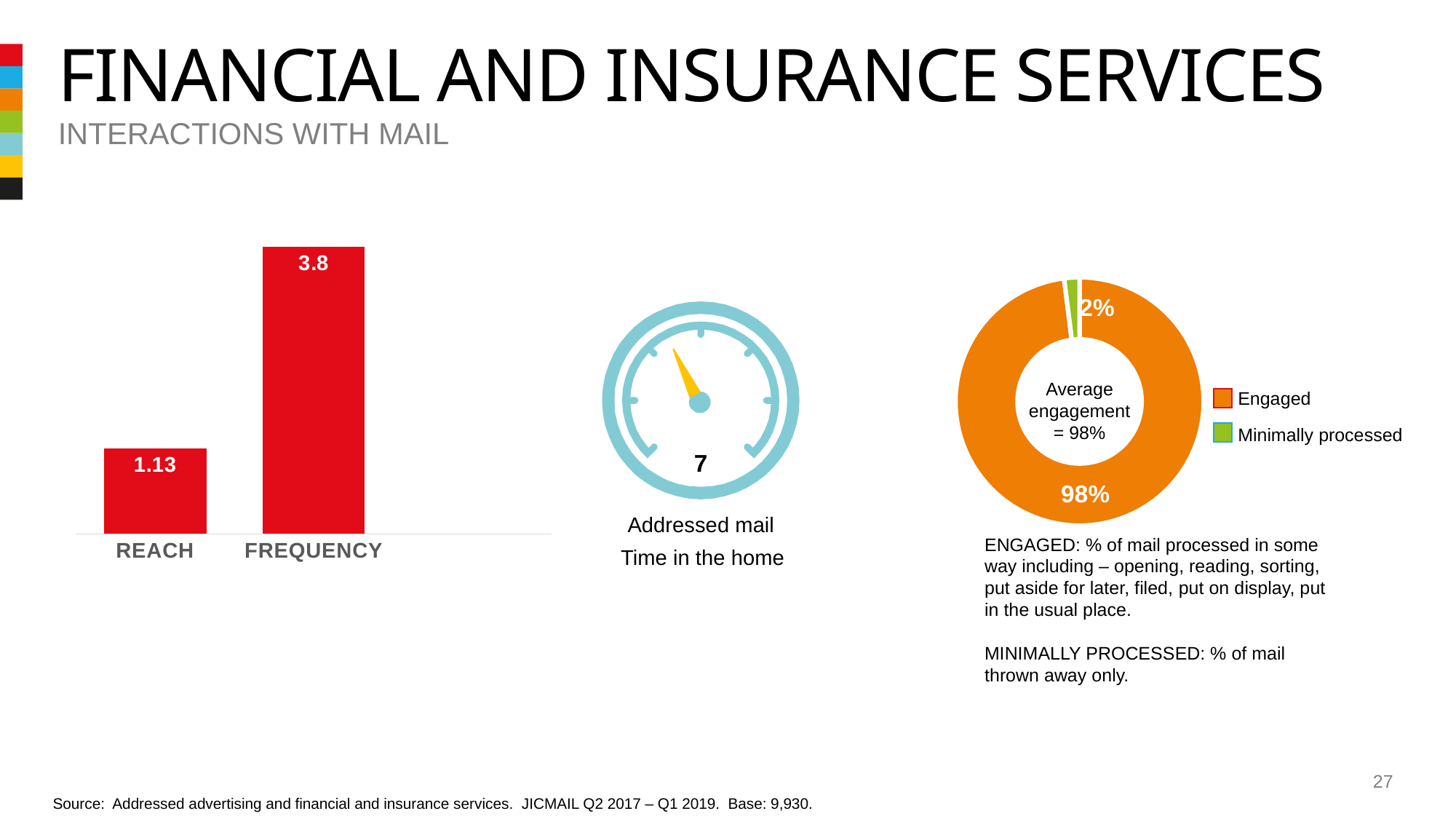
In the bar chart on the left, what is the value for FREQUENCY? 3.8 In the bar chart on the left, which category has the lower value? REACH What value is shown on the gauge in the middle of the slide for addressed mail time in the home? 7 In the donut chart on the right, what share is Minimally processed? 2% In the bar chart on the left, what is the difference between the FREQUENCY and REACH values? 2.67 In the bar chart on the left, what is the value for REACH? 1.13 What kind of chart is shown on the left of the slide? Bar chart In the donut chart on the right, how many entries does the legend list? 2 In the bar chart on the left, how many categories are shown? 2 In the bar chart on the left, which category has the higher value? FREQUENCY In the donut chart on the right, what share is Engaged? 98%